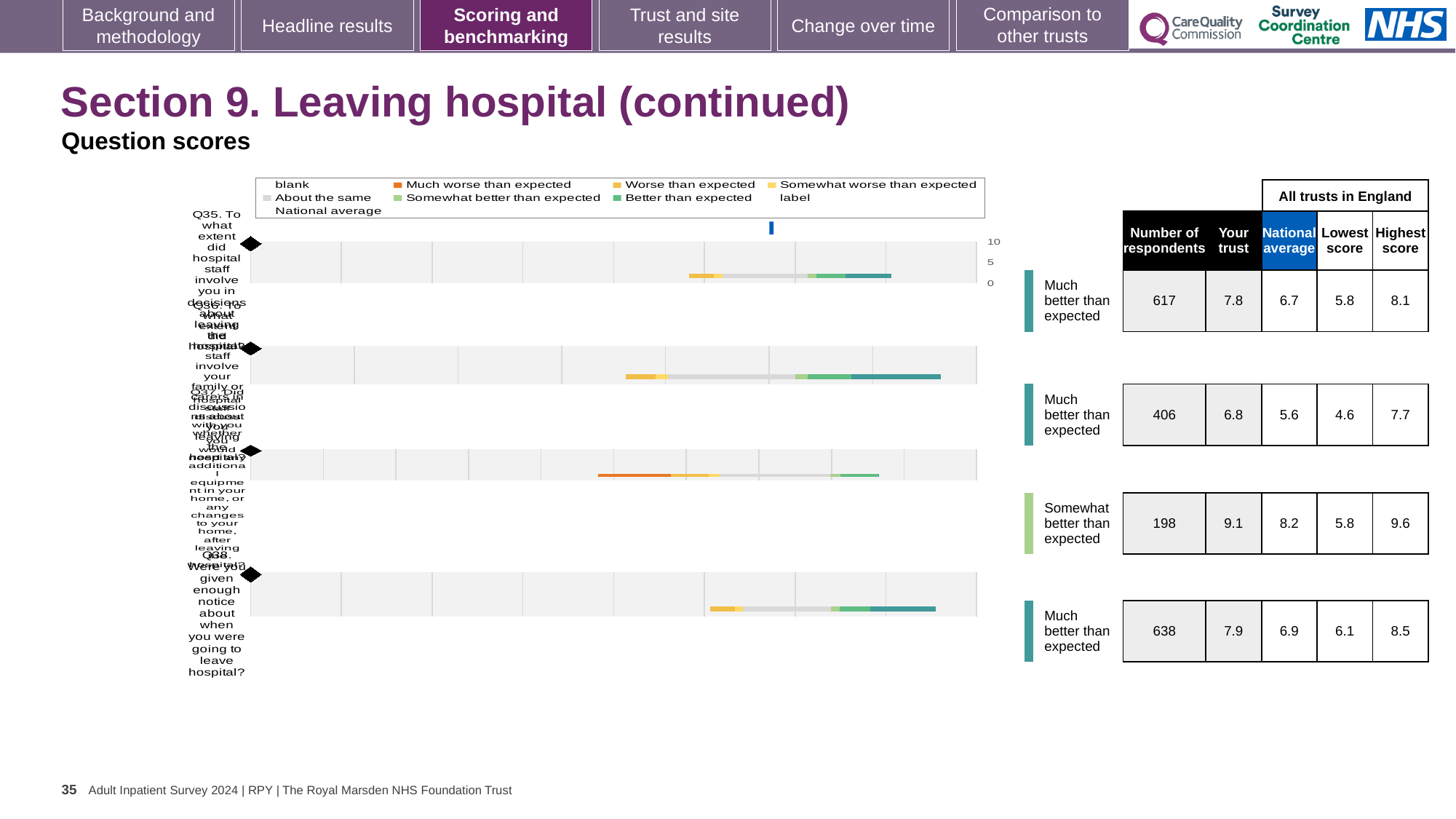
What is the difference between the 'Your trust' score and the national average for Q35 (the first row)? 1.1 How many entries does the chart legend list? 9 In the table beside the chart, what is the national average for the third row? 8.2 Is the 'Your trust' score for Q38 (the last row) larger or smaller than the national average for that row? larger What benchmark category is shown next to the first row of the table? Much better than expected In the table beside the chart, what is the highest score for the second row? 7.7 In the table beside the chart, what is the 'Your trust' score for Q35 (the first row)? 7.8 What kind of chart is shown on the slide? bar chart In the table beside the chart, what is the number of respondents for Q38 (the last row)? 638 Which row of the table has the highest 'Your trust' score? the third row (9.1) How many question bars are plotted in the chart? 4 Which row of the table has the lowest number of respondents? the third row (198)